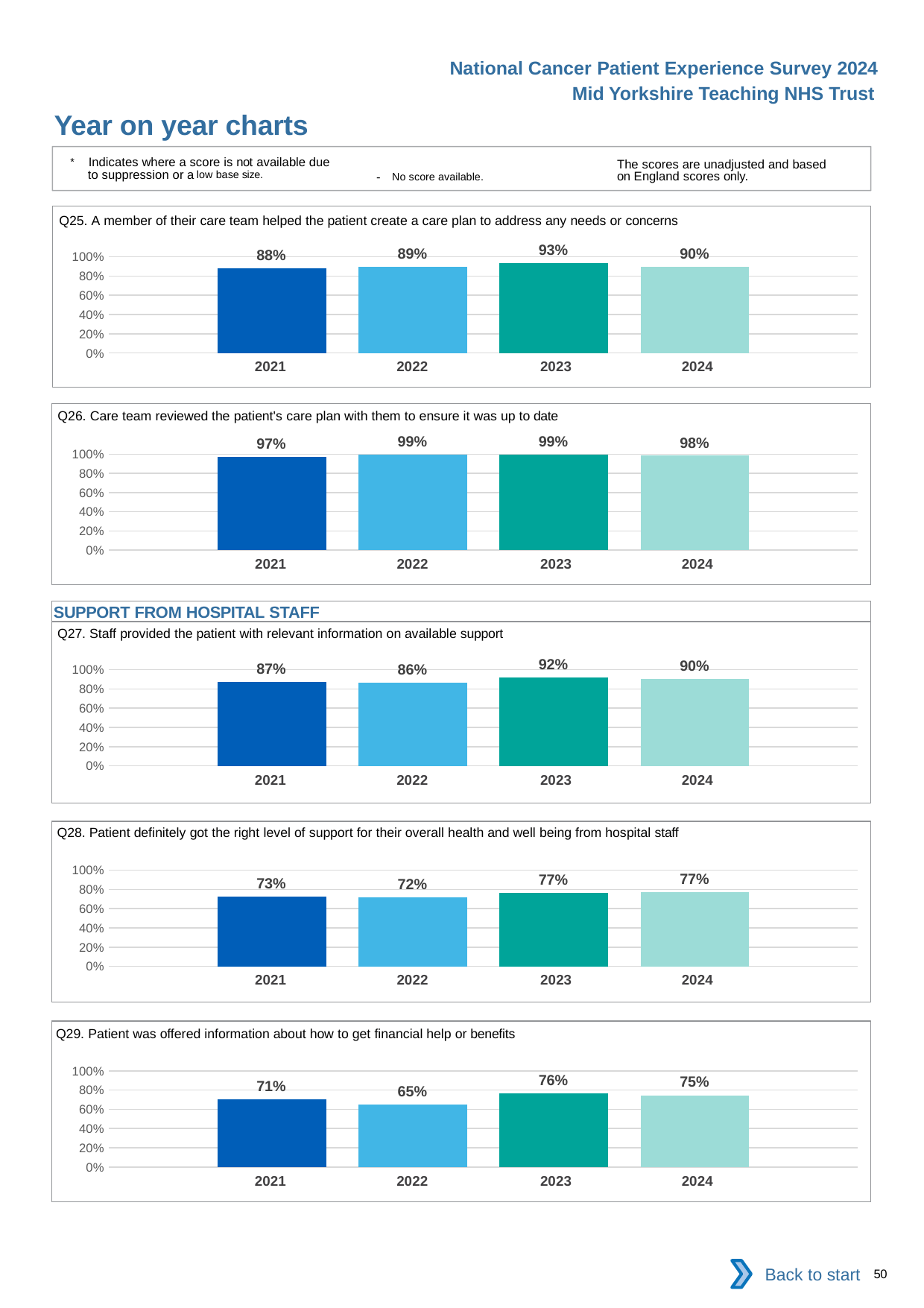
In the Q27 chart, which year has the highest value? 2023 What type of chart is the Q25 chart? bar chart In the Q28 chart, what is the value for 2024? 77% In the Q25 chart, what is the value for 2023? 93% In the Q28 chart, is the value for 2021 larger or smaller than the value for 2022? larger In the Q29 chart, which year has the lowest value? 2022 In the Q27 chart, what is the value for 2022? 86% In the Q25 chart, which year has the lowest value? 2021 In the Q26 chart, what is the value for 2021? 97% How many years are shown in the Q29 chart? 4 In the Q26 chart, what is the difference between the 2022 and 2021 values? 2% In the Q29 chart, what is the difference between the 2023 and 2022 values? 11%